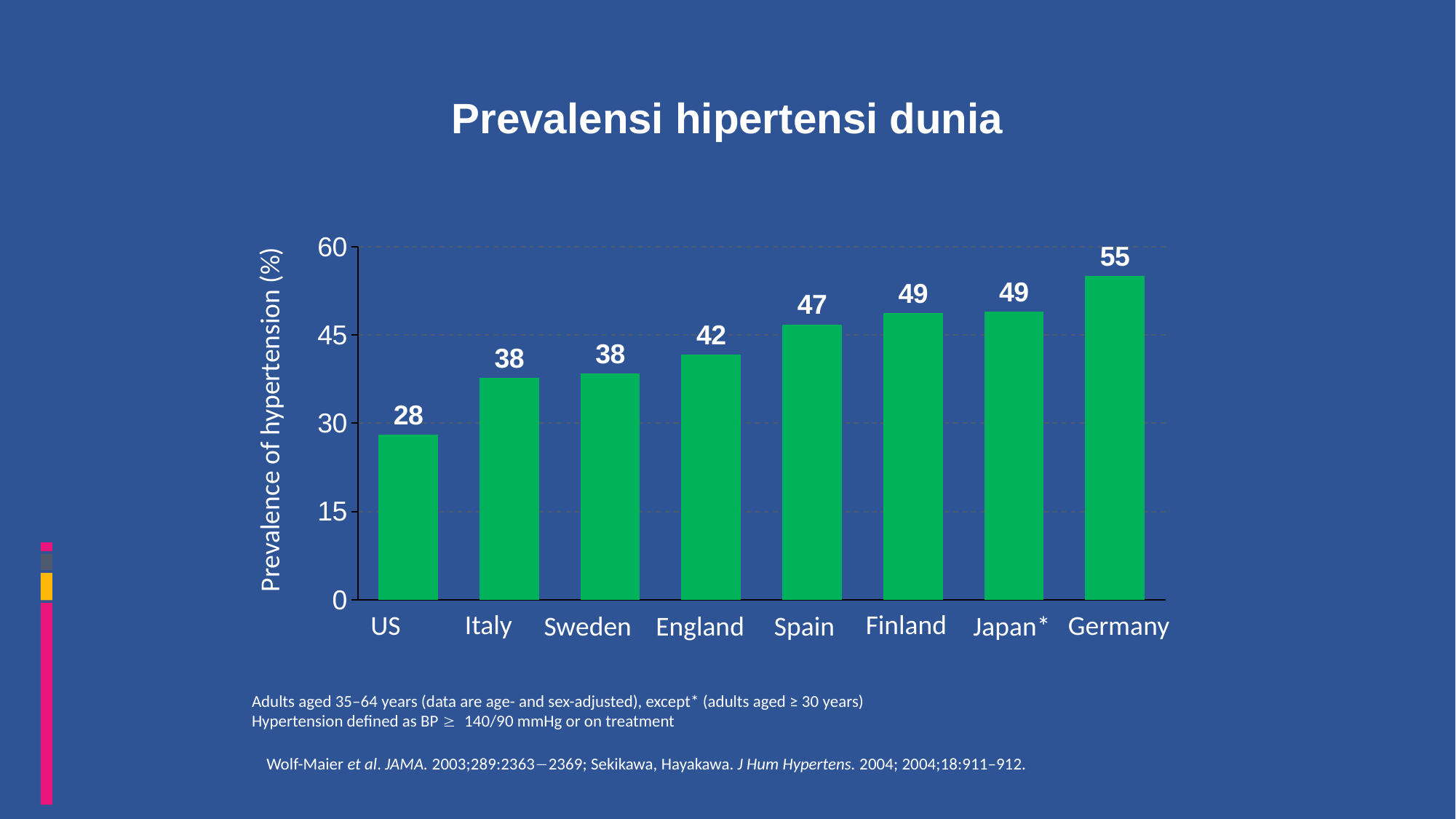
What is the prevalence of hypertension for Germany? 55 Which has a higher prevalence of hypertension, Spain or Italy? Spain What is the prevalence of hypertension for Spain? 47 Which country has the lowest prevalence of hypertension? US Is the value for England greater or less than 45? less What is the difference in prevalence of hypertension between Finland and England? 7 What kind of chart is shown on the slide? Bar chart What is the difference in prevalence of hypertension between Germany and the US? 27 What is the label of the vertical axis? Prevalence of hypertension (%) How many countries are shown in the chart? 8 Which country has the highest prevalence of hypertension? Germany What is the prevalence of hypertension for the US? 28